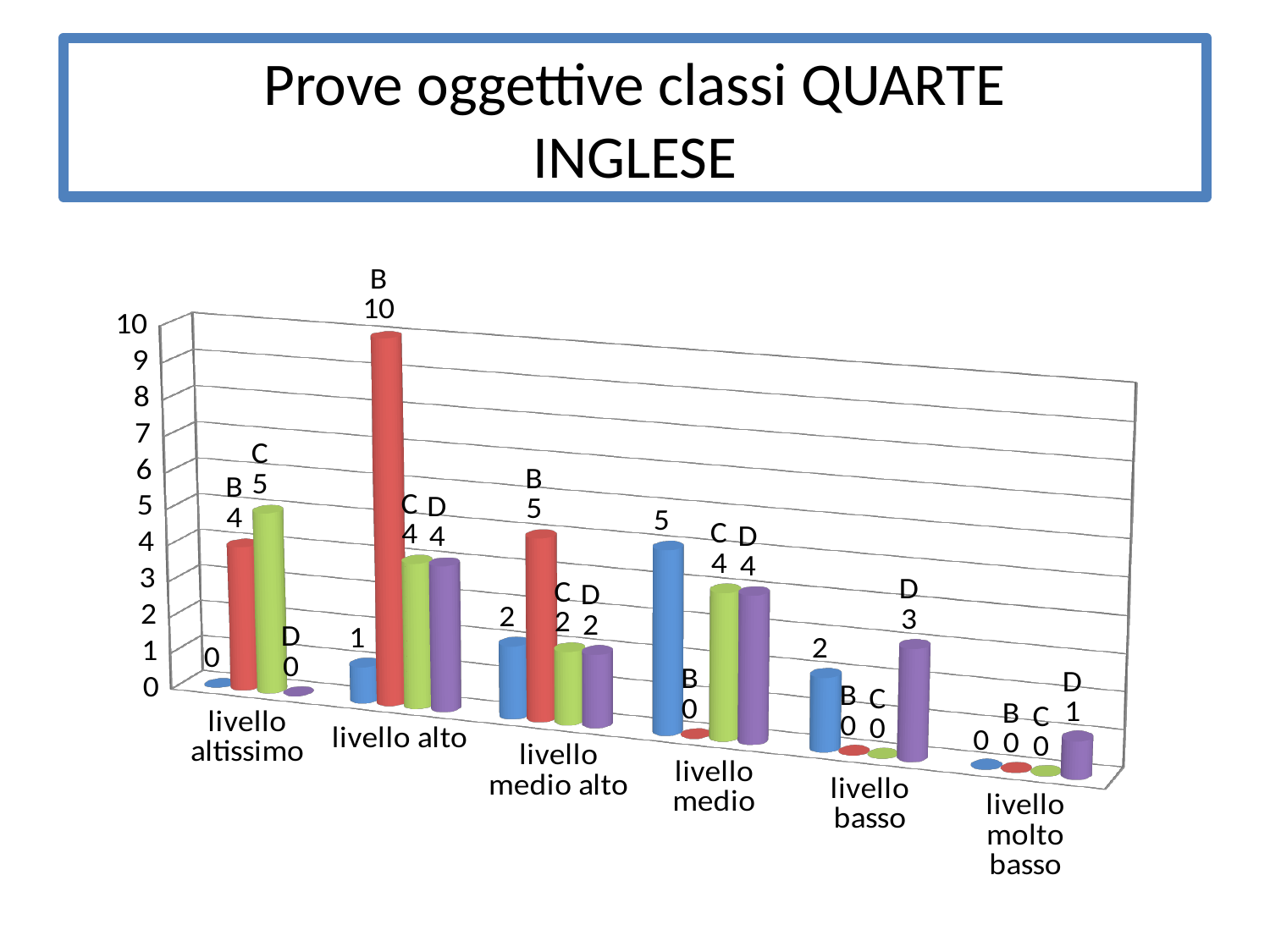
What is the value for series B in the 'livello alto' category? 10 Which series has the lowest value in the 'livello basso' category? B and C (both 0) What is the difference between series B and series C in the 'livello alto' category? 6 What kind of chart is shown on the slide? bar chart How many categories are shown on the x axis? 6 What is the title of the slide containing the chart? Prove oggettive classi QUARTE INGLESE What is the total of the four bars in the 'livello molto basso' category? 1 In which category does series B reach its highest value? livello alto What is the value for series D in the 'livello basso' category? 3 What is the value for series C in the 'livello altissimo' category? 5 What is the value of the blue bar in the 'livello medio' category? 5 In the 'livello medio alto' category, which is larger: series B or series D? series B